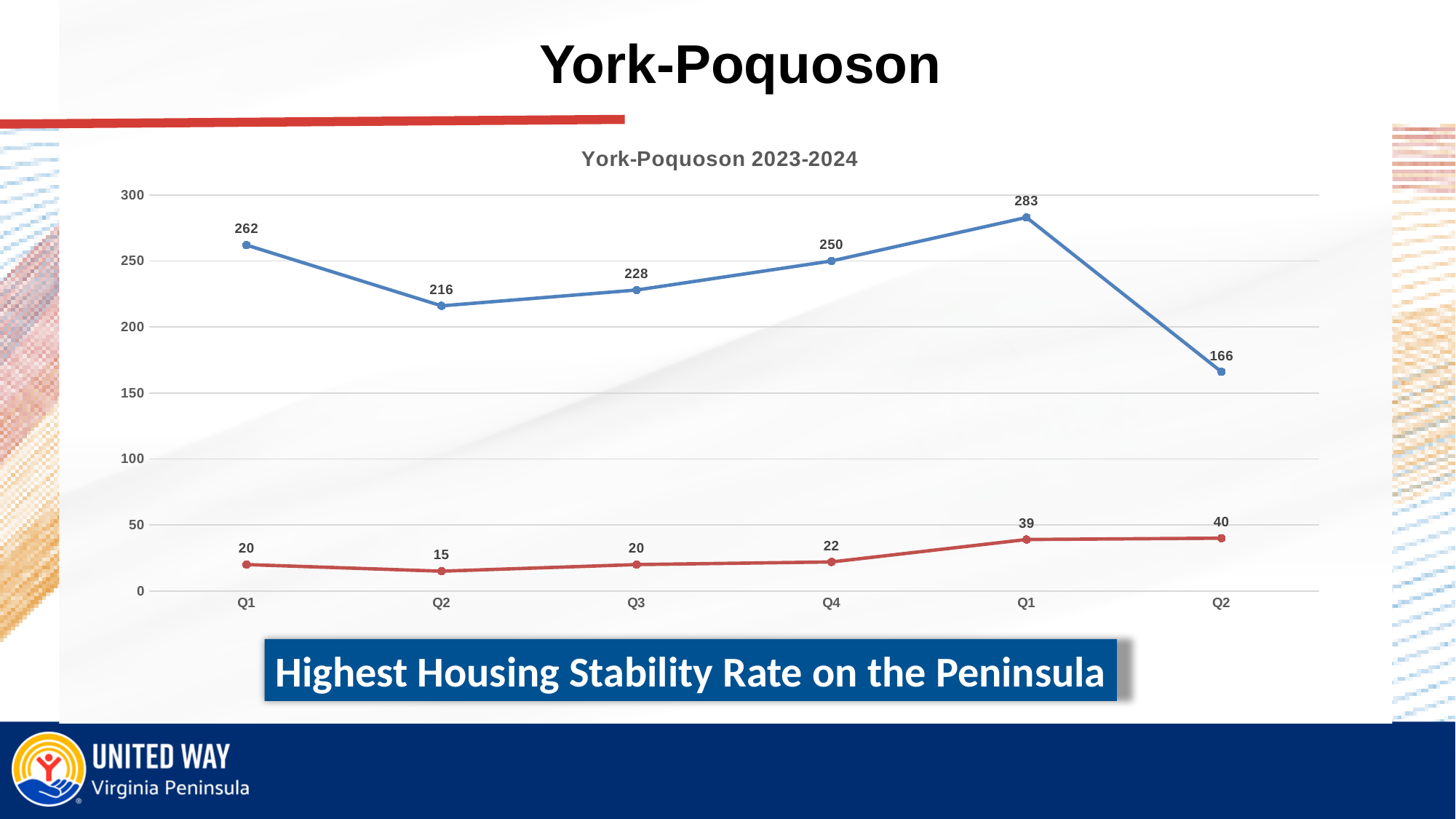
What is the value of the blue line at the first Q1? 262 Does the red line rise or fall from Q4 to the second Q1? rise How many data points does each line have? 6 What kind of chart is shown on the slide? line chart Is the blue line's value at the final Q2 greater or less than 200? less Which is larger: the blue line's value at Q3 or at Q4? Q4 What is the value of the red line at Q4? 22 What is the title of the chart? York-Poquoson 2023-2024 What is the difference between the blue line's value at the second Q1 (283) and at the final Q2 (166)? 117 What is the lowest value on the red line? 15 At which quarter does the blue line reach its highest value? Q1 (the second Q1, 283) What is the value of the blue line at the last Q2 (the final point)? 166